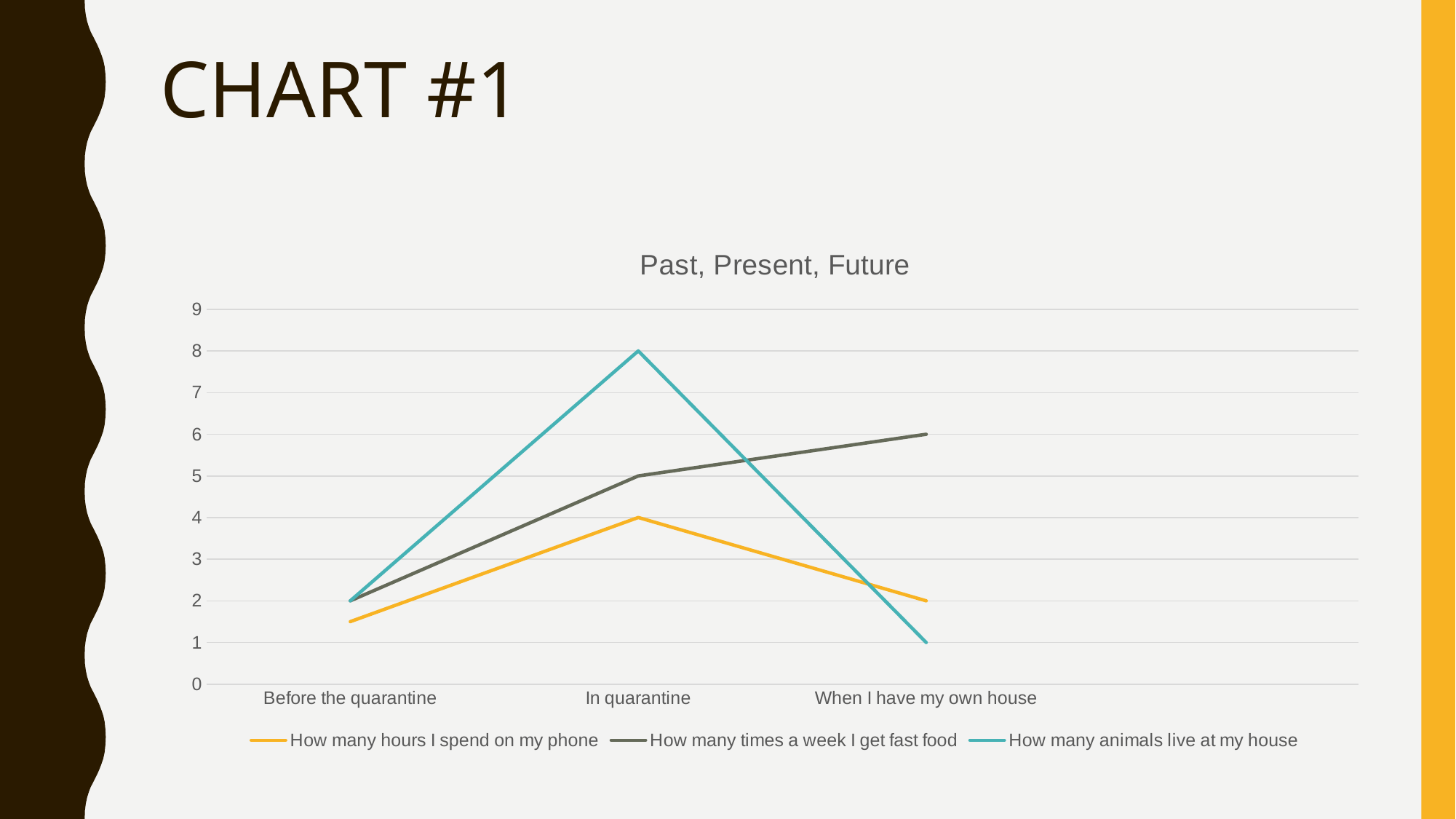
What is the value for 'How many hours I spend on my phone' in quarantine? 4 In which category is 'How many animals live at my house' highest? In quarantine What is the difference between 'How many times a week I get fast food' in quarantine and before the quarantine? 3 Does 'How many times a week I get fast food' rise or fall across the categories from left to right? rise What kind of chart is shown on the slide? line chart What is the title of the chart? Past, Present, Future How many categories are shown on the x axis? 3 Is the value for 'How many hours I spend on my phone' before the quarantine greater or less than 2? less What is the value for 'How many animals live at my house' when I have my own house? 1 How many series does the legend list? 3 What is the value for 'How many times a week I get fast food' when I have my own house? 6 What is the value for 'How many animals live at my house' in quarantine? 8